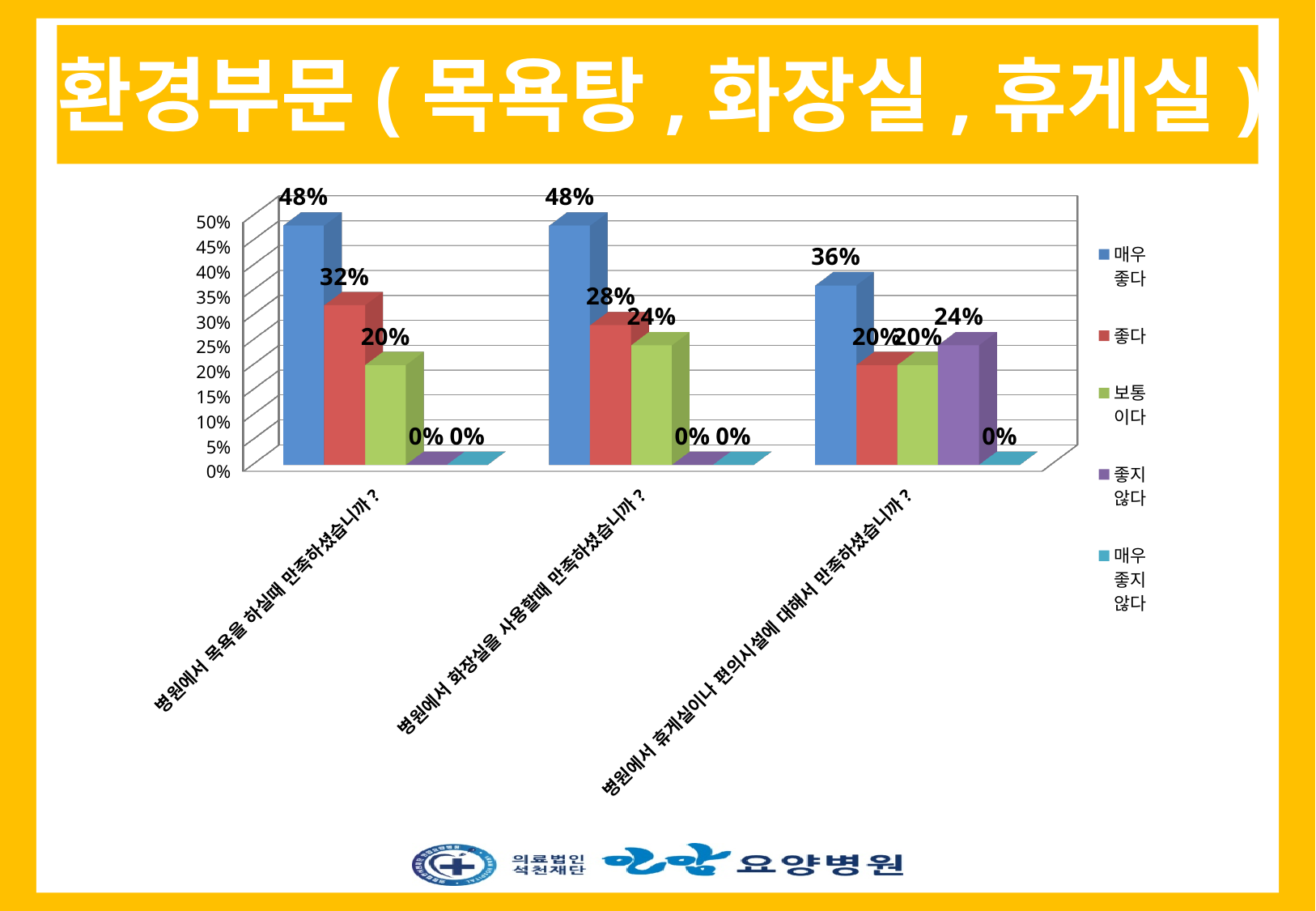
What is the value of 좋다 for 병원에서 화장실을 사용할때 만족하셨습니까? 28% How many categories (questions) are shown on the x axis? 3 What is the value of 보통이다 for 병원에서 화장실을 사용할때 만족하셨습니까? 24% How many series does the legend list? 5 What is the value of 매우 좋지 않다 for 병원에서 화장실을 사용할때 만족하셨습니까? 0% What is the difference between 매우 좋다 and 좋다 for 병원에서 목욕을 하실때 만족하셨습니까? 16% Which is larger for 병원에서 휴게실이나 편의시설에 대해서 만족하셨습니까?: 좋지 않다 or 좋다? 좋지 않다 What is the value of 좋지 않다 for 병원에서 휴게실이나 편의시설에 대해서 만족하셨습니까? 24% Does the value of 매우 좋다 for 병원에서 목욕을 하실때 만족하셨습니까? rise or fall compared with 병원에서 휴게실이나 편의시설에 대해서 만족하셨습니까? fall What kind of chart is shown on the slide? bar chart What is the value of 매우 좋다 for 병원에서 목욕을 하실때 만족하셨습니까? 48% Which category has the lowest value for 매우 좋다? 병원에서 휴게실이나 편의시설에 대해서 만족하셨습니까?